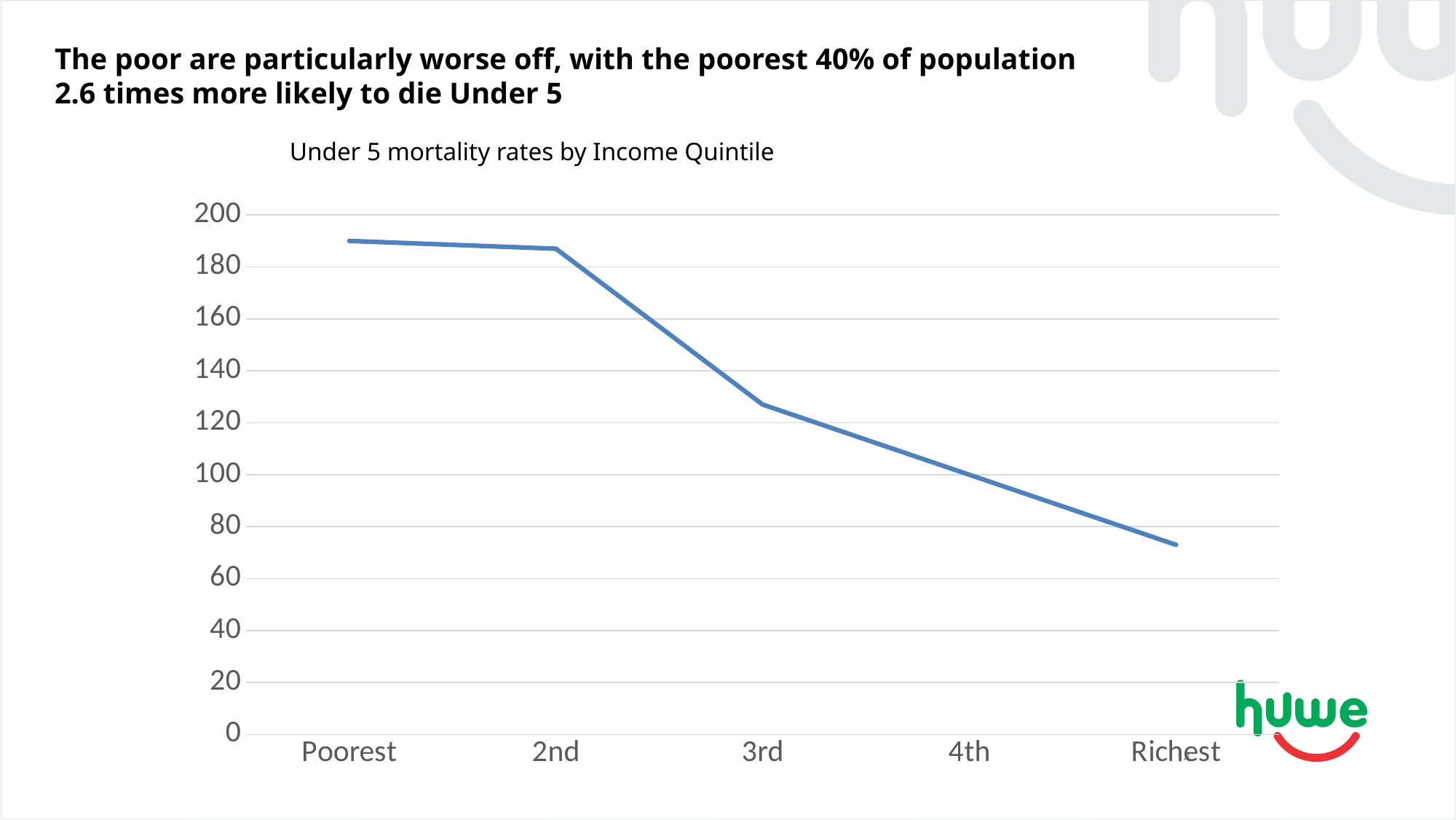
How many income quintile categories are plotted on the x axis? 5 Is the value for 2nd greater or less than 160? greater Which income quintile has the lowest under 5 mortality rate? Richest Is the value for Richest greater or less than 80? less Is the value for 3rd greater or less than 120? greater Do the under 5 mortality rates rise or fall from Poorest to Richest along the x axis? fall What is the title of the chart? Under 5 mortality rates by Income Quintile What kind of chart is shown on the slide? line chart Which has the higher under 5 mortality rate, 2nd or 3rd? 2nd